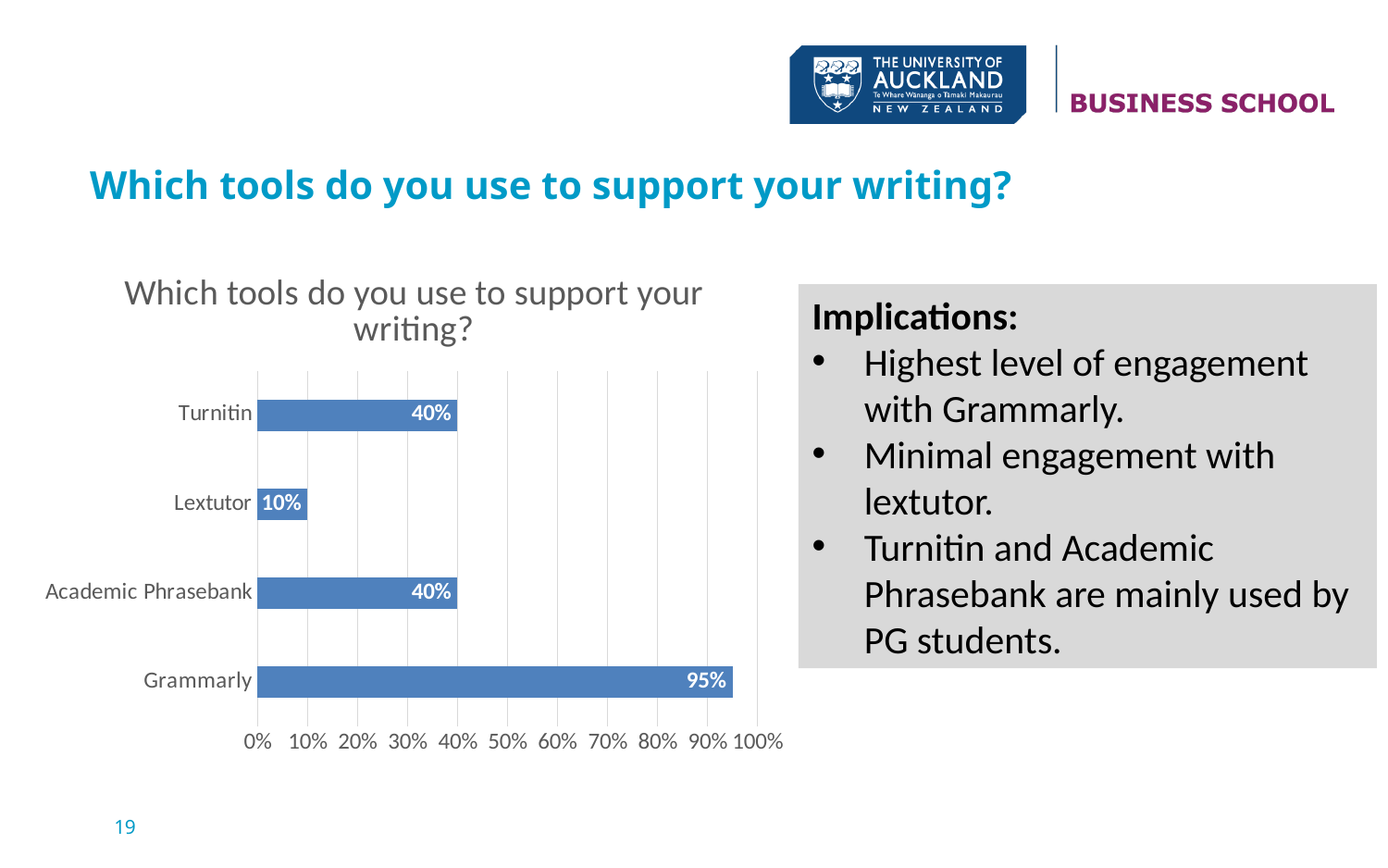
Which tool has the highest percentage of use? Grammarly Which has a larger value, Lextutor or Academic Phrasebank? Academic Phrasebank What is the difference between the values for Academic Phrasebank and Lextutor? 30% What is the difference between the values for Grammarly and Turnitin? 55% Which tool has the lowest percentage of use? Lextutor What is the title of the chart? Which tools do you use to support your writing? What is the value shown for Turnitin? 40% What percentage of respondents use Grammarly to support their writing? 95% What type of chart is shown on the slide? Bar chart Is the value for Grammarly greater or less than 90%? greater How many tools are shown in the chart? 4 What is the value shown for Lextutor? 10%